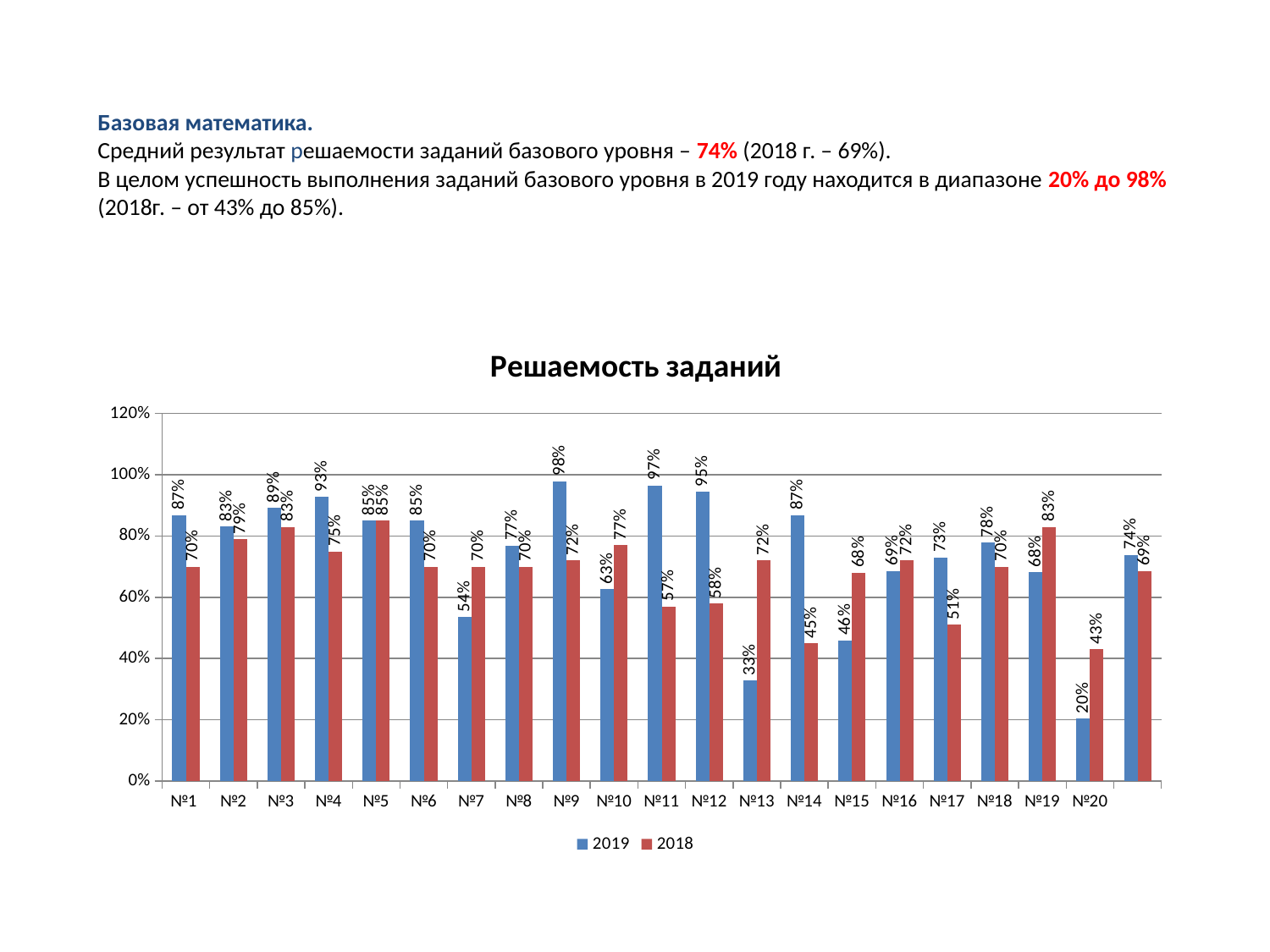
Which task has the lowest 2019 value? №20 What is the title of the chart? Решаемость заданий How many series does the legend list? 2 What is the difference between the 2019 and 2018 values for №11? 40% Which task has the highest 2019 value? №9 What type of chart is shown on the slide? Bar chart What is the 2019 value for №9 in the chart "Решаемость заданий"? 98% Which task has the highest 2018 value? №5 What is the 2019 value for №13? 33% How many tasks (categories) are shown on the x axis? 20 What is the 2018 value for №14? 45% Which is larger for №7: the 2019 value or the 2018 value? 2018